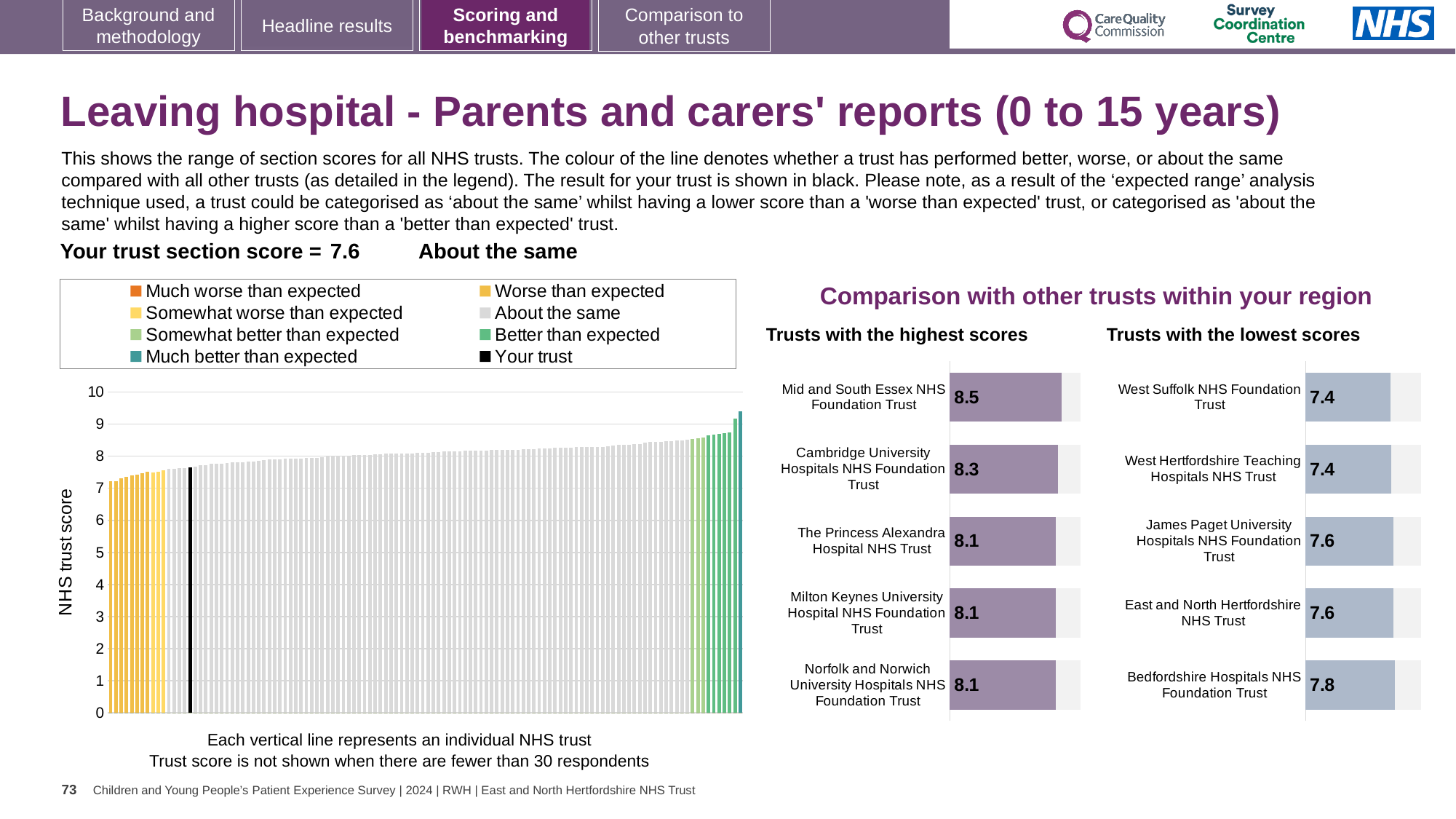
In the large chart on the left, do the trust scores rise or fall from left to right? rise In the 'Trusts with the lowest scores' chart, which has the larger score: Bedfordshire Hospitals NHS Foundation Trust or West Suffolk NHS Foundation Trust? Bedfordshire Hospitals NHS Foundation Trust In the large chart on the left, is the value of the shortest bar greater or less than 8? less In the 'Trusts with the highest scores' chart, which trust has the highest score? Mid and South Essex NHS Foundation Trust In the large chart on the left, is the value of the tallest bar greater or less than 9? greater How many trusts are shown in the 'Trusts with the lowest scores' chart? 5 In the large chart on the left, what is the maximum value shown on the NHS trust score axis? 10 How many entries does the legend above the large chart on the left list? 8 In the 'Trusts with the highest scores' chart, what is the difference between the scores of Mid and South Essex NHS Foundation Trust and Cambridge University Hospitals NHS Foundation Trust? 0.2 In the 'Trusts with the lowest scores' chart, what is the score for Bedfordshire Hospitals NHS Foundation Trust? 7.8 In the 'Trusts with the highest scores' chart, what is the score for Mid and South Essex NHS Foundation Trust? 8.5 What kind of chart is the large chart on the left showing NHS trust scores? bar chart